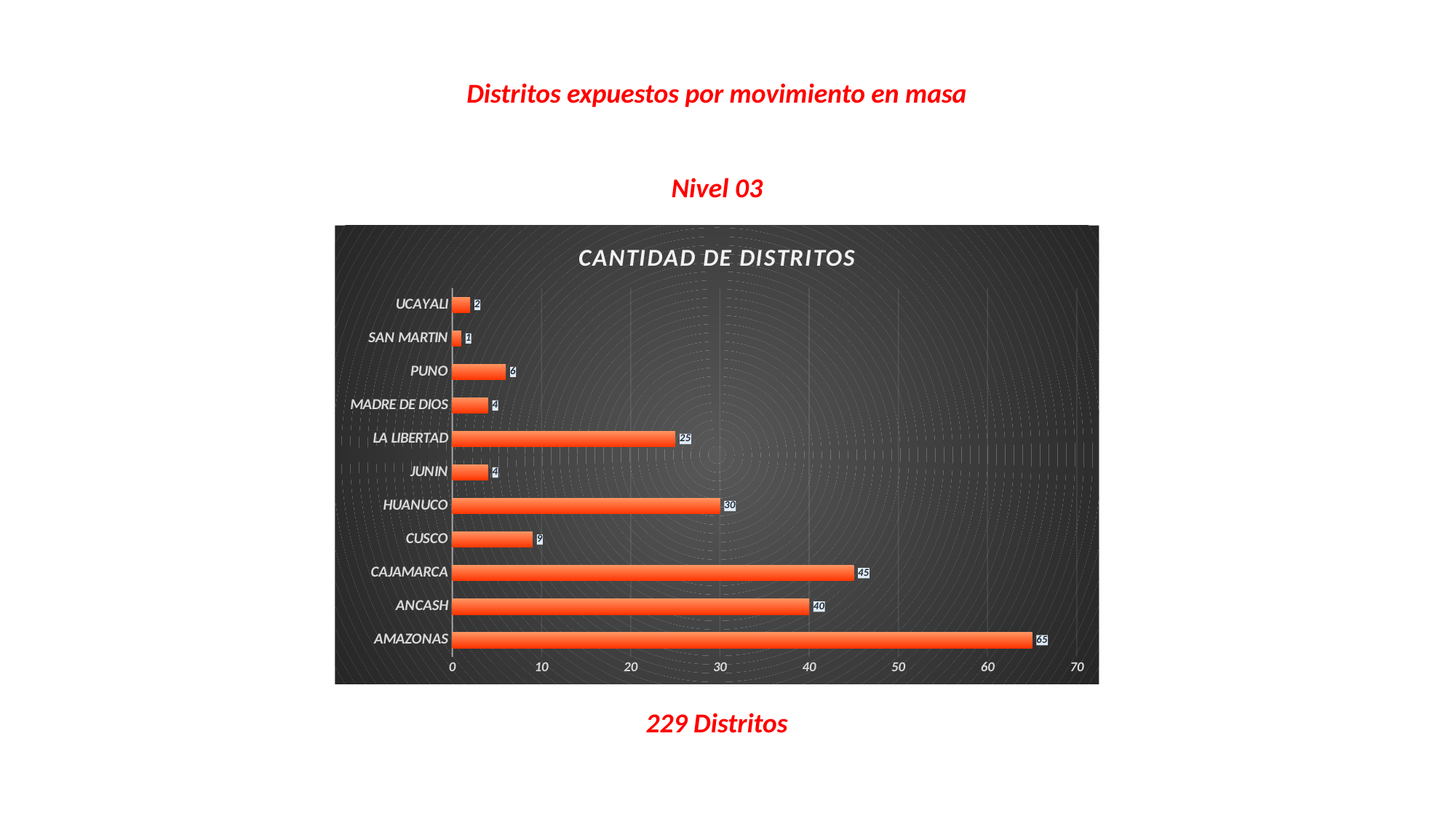
Is the value for ANCASH greater or less than 30? greater How many categories are shown in the chart? 11 What is the difference between the values for PUNO and MADRE DE DIOS? 2 What is the value for AMAZONAS? 65 What is the difference between the values for CAJAMARCA and ANCASH? 5 What is the value for CUSCO? 9 Which category has the highest value? AMAZONAS Which category has the lowest value? SAN MARTIN What is the value for LA LIBERTAD? 25 Which is larger, the value for HUANUCO or the value for LA LIBERTAD? HUANUCO What is the title of the chart? CANTIDAD DE DISTRITOS What kind of chart is shown? bar chart